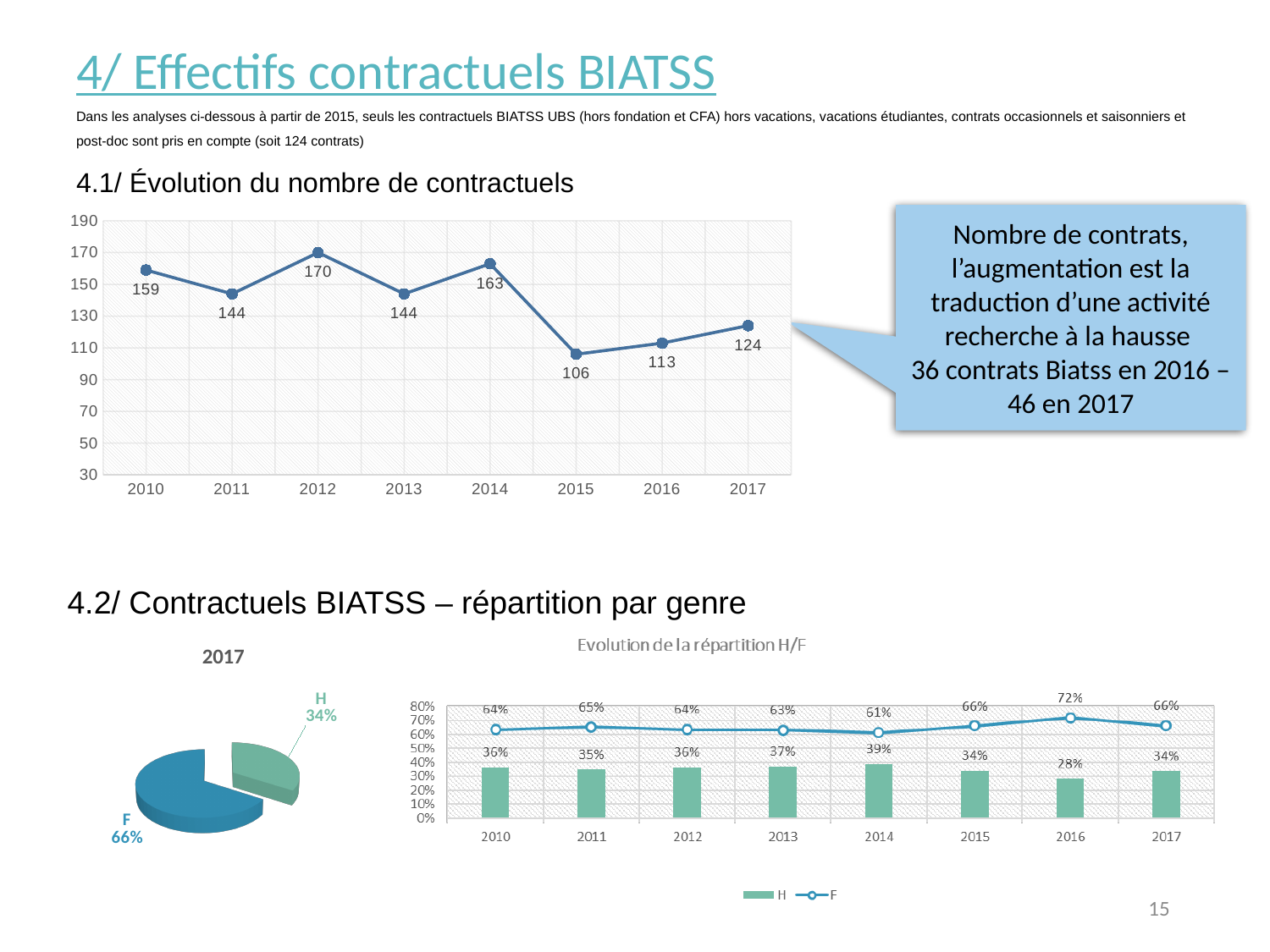
In the chart titled Evolution de la répartition H/F, what is the value for H in 2014? 39% In the chart titled Evolution de la répartition H/F, how many series does the legend list? 2 In the line chart under 4.1 Évolution du nombre de contractuels, which year has the lowest value? 2015 In the pie chart titled 2017, which slice is larger, H or F? F In the chart titled Evolution de la répartition H/F, what is the value for F in 2016? 72% In the line chart under 4.1 Évolution du nombre de contractuels, how many years are plotted? 8 In the line chart under 4.1 Évolution du nombre de contractuels, which year has the highest value? 2012 In the line chart under 4.1 Évolution du nombre de contractuels, what is the difference between the 2014 value and the 2015 value? 57 In the chart titled Evolution de la répartition H/F, which year has the lowest value for H? 2016 In the pie chart titled 2017, what share does F have? 66% In the line chart under 4.1 Évolution du nombre de contractuels, what is the value for 2012? 170 In the line chart under 4.1 Évolution du nombre de contractuels, do the values rise or fall from 2015 to 2017? rise